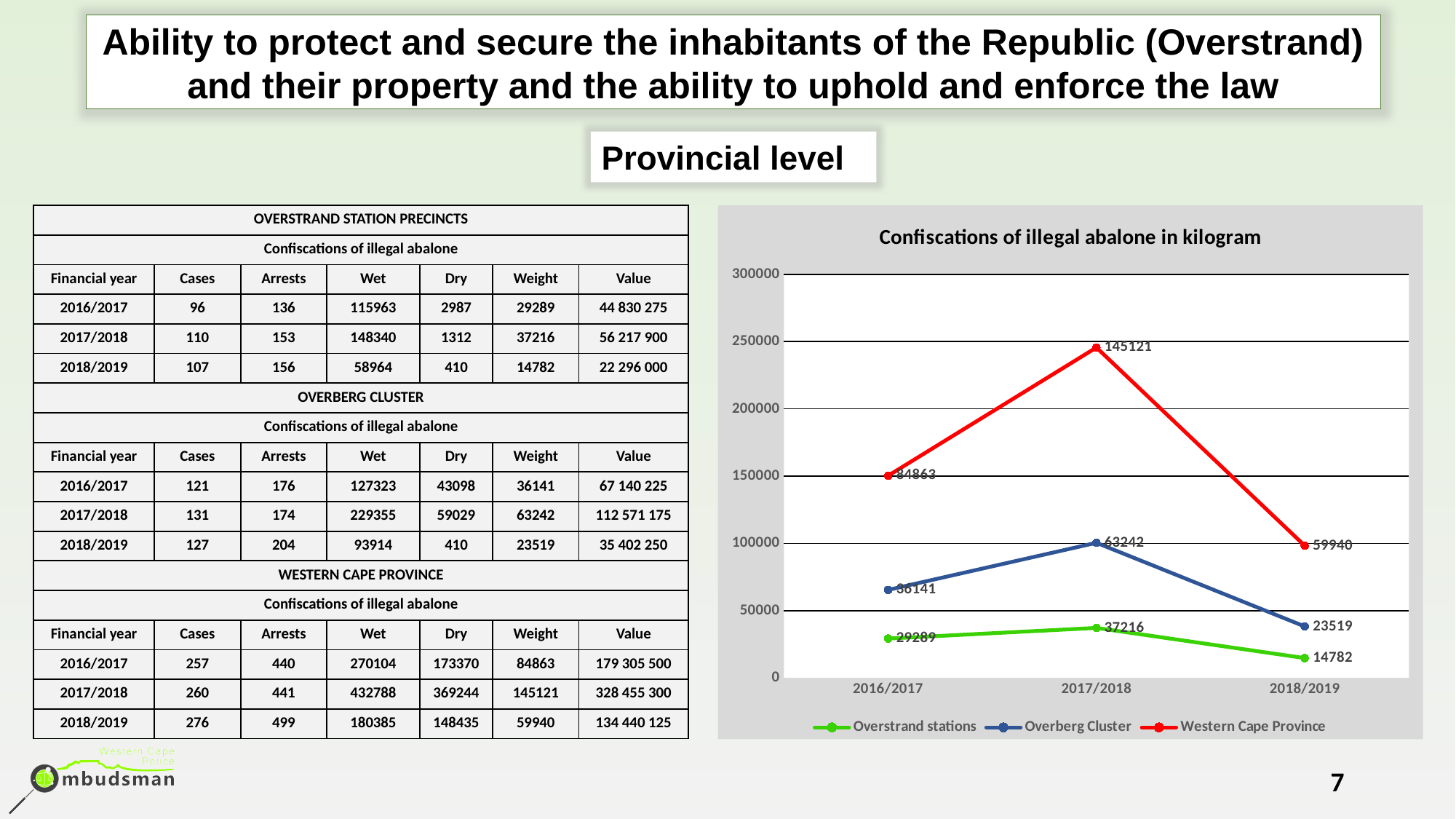
What is the difference between the Western Cape Province value and the Overberg Cluster value in 2018/2019? 36421 In which financial year is the Overstrand stations value lowest? 2018/2019 How many financial years are plotted on the x axis of the chart? 3 In which financial year is the Western Cape Province value highest? 2017/2018 What is the value for Overberg Cluster in 2018/2019? 23519 How many series does the chart legend list? 3 Which is larger in 2016/2017: the Overberg Cluster value or the Overstrand stations value? Overberg Cluster What is the value for Overstrand stations in 2016/2017? 29289 Does the Overberg Cluster line rise or fall from 2017/2018 to 2018/2019? fall What is the title of the chart? Confiscations of illegal abalone in kilogram What type of chart is shown on the slide? line chart What is the value for Western Cape Province in 2017/2018? 145121